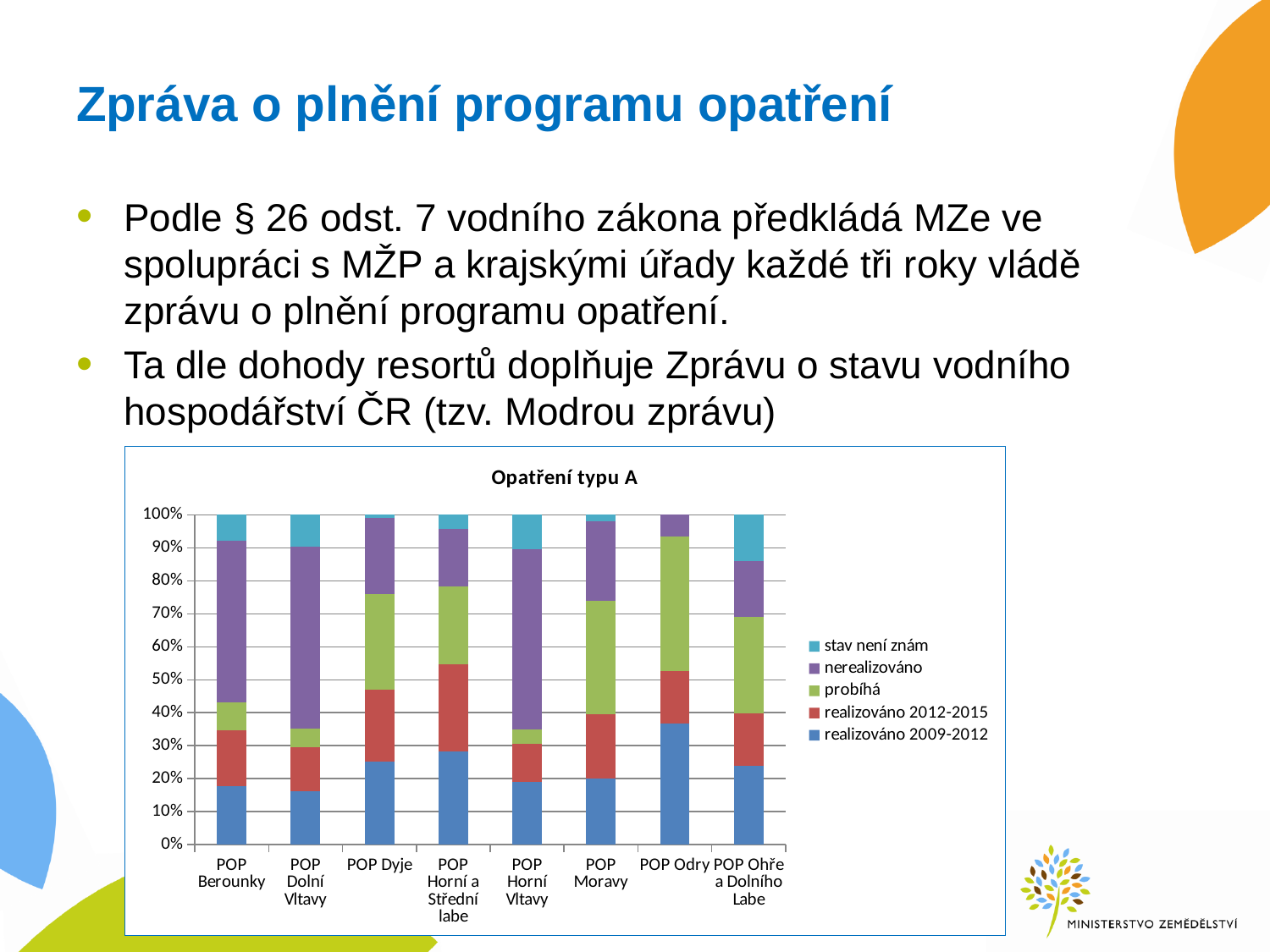
What is the title of the chart on the slide? Opatření typu A What is the total height of each stacked bar in the chart? 100% What kind of chart is shown on the slide? Stacked bar chart Is the 'realizováno 2009-2012' value for POP Dolní Vltavy greater or less than 20%? less Is the 'realizováno 2009-2012' value for POP Dyje greater or less than 20%? greater Which legend entry is shown in blue at the bottom of each bar? realizováno 2009-2012 How many categories (POP groups) are shown on the x axis of the chart? 8 Which has the larger 'stav není znám' segment: POP Ohře a Dolního Labe or POP Dyje? POP Ohře a Dolního Labe How many series does the chart's legend list? 5 Which category has the smallest 'nerealizováno' segment? POP Odry Is the 'realizováno 2009-2012' value for POP Odry greater or less than 30%? greater Which category has the largest 'realizováno 2009-2012' segment? POP Odry